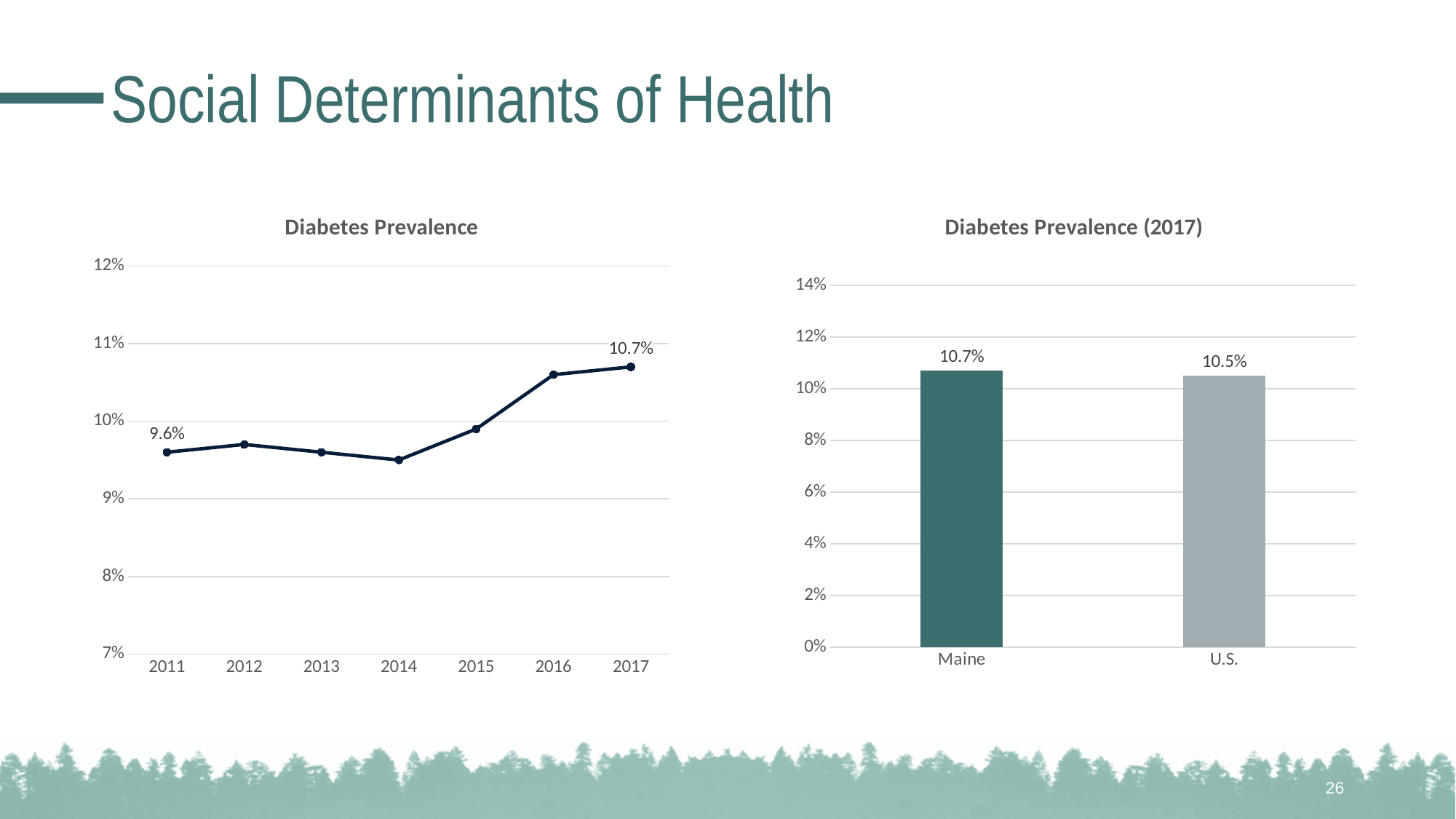
In the 'Diabetes Prevalence' line chart, does the value generally rise or fall from 2014 to 2017? rise In the 'Diabetes Prevalence (2017)' bar chart, what is the value for Maine? 10.7% In the 'Diabetes Prevalence' line chart, what is the value for 2011? 9.6% In the 'Diabetes Prevalence' line chart, what is the value for 2017? 10.7% In the 'Diabetes Prevalence' line chart, what is the difference between the 2017 and 2011 values? 1.1% In the 'Diabetes Prevalence (2017)' bar chart, what is the difference between the Maine and U.S. values? 0.2% In the 'Diabetes Prevalence' line chart, is the value for 2016 greater or less than 10%? greater In the 'Diabetes Prevalence' line chart, how many years are plotted on the x axis? 7 In the 'Diabetes Prevalence (2017)' bar chart, how many categories are shown? 2 In the 'Diabetes Prevalence' line chart, is the value for 2014 greater or less than 10%? less In the 'Diabetes Prevalence (2017)' bar chart, what is the value for U.S.? 10.5% What kind of chart is the 'Diabetes Prevalence (2017)' chart on the right? bar chart